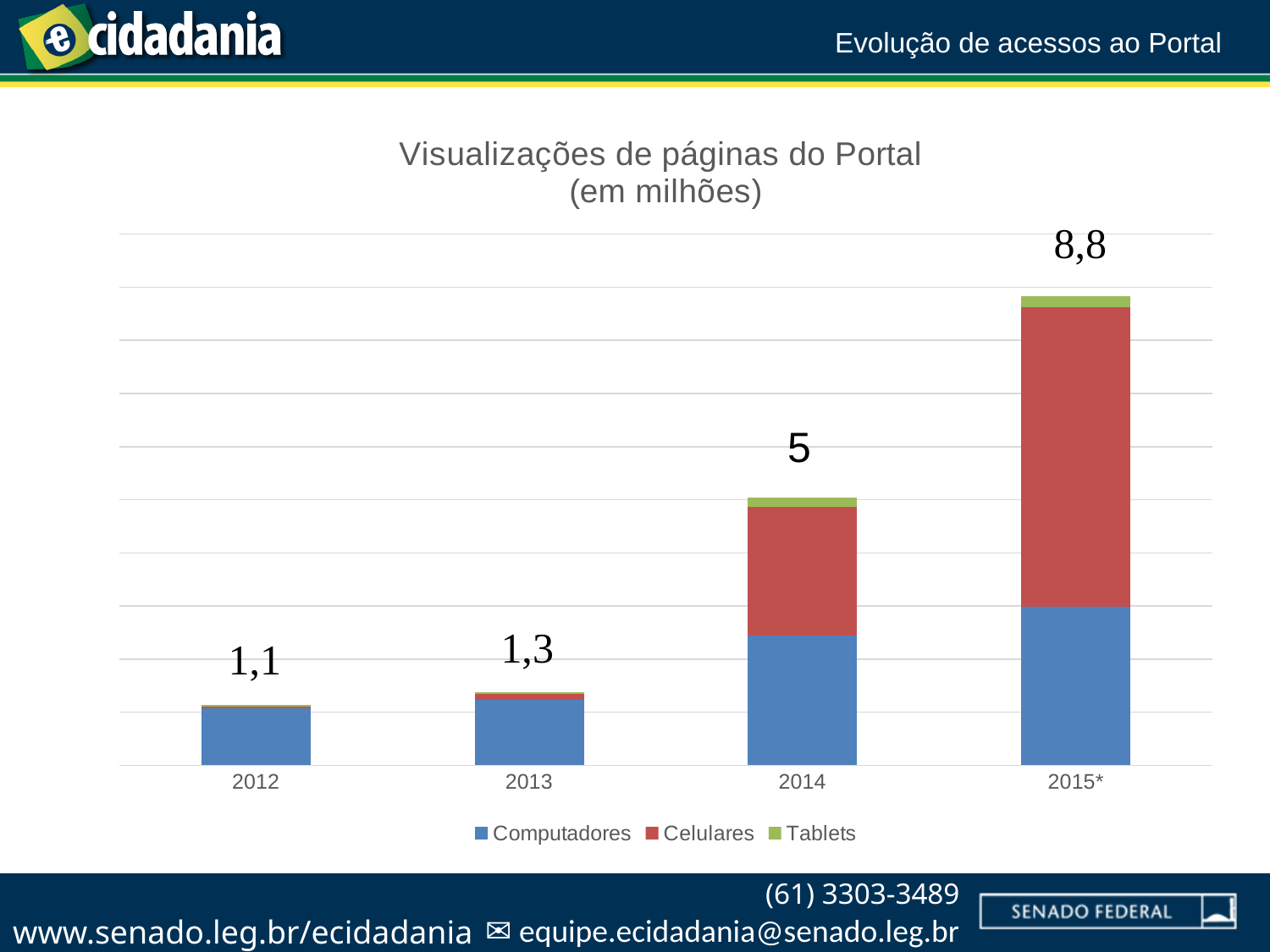
Which year has the highest total page views? 2015* What is the total value labelled for 2012? 1,1 What is the difference between the totals for 2015* and 2014? 3,8 How many series does the legend list? 3 What is the total value labelled for 2015*? 8,8 Which year has the lowest total page views? 2012 What kind of chart is shown on the slide? Stacked bar chart Which year has a larger total, 2013 or 2014? 2014 What is the total value labelled for 2014? 5 How many years are shown on the x axis? 4 Do the total page views rise or fall from 2012 to 2015*? Rise What is the difference between the totals for 2013 and 2012? 0,2